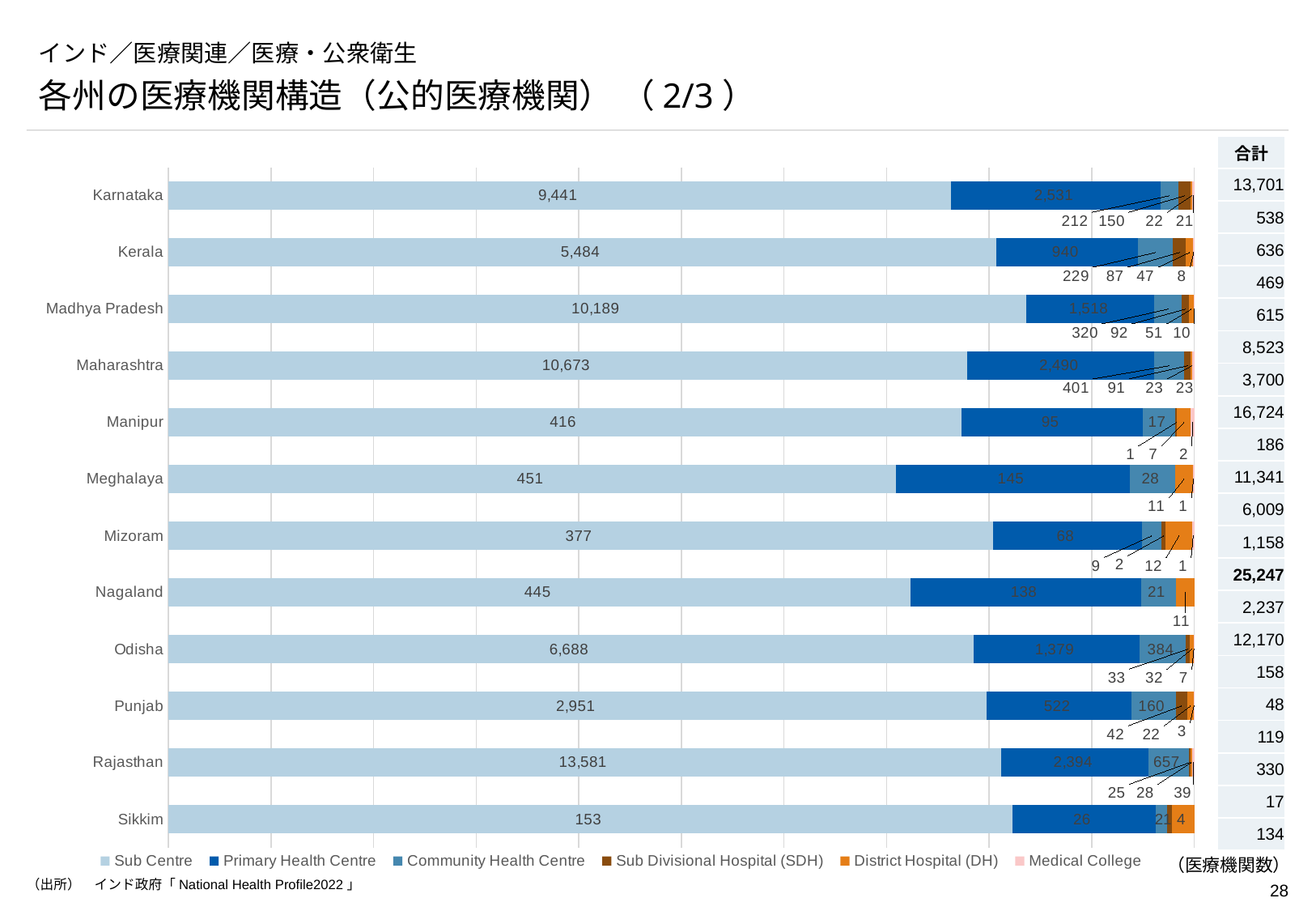
How many series does the legend list? 6 What is the Community Health Centre value for Maharashtra? 401 What is the Primary Health Centre value for Karnataka? 2,531 Which series is listed last in the legend? Medical College How many states are shown on the chart? 12 What is the Sub Centre value for Rajasthan? 13,581 Which state has the lowest Sub Centre value? Sikkim What kind of chart is shown on the slide? Stacked bar chart What is the Sub Centre value for Sikkim? 153 Which state has the highest Sub Centre value? Rajasthan Which is larger, the Primary Health Centre value for Kerala or for Odisha? Odisha What is the difference between the Sub Centre values of Maharashtra and Madhya Pradesh? 484